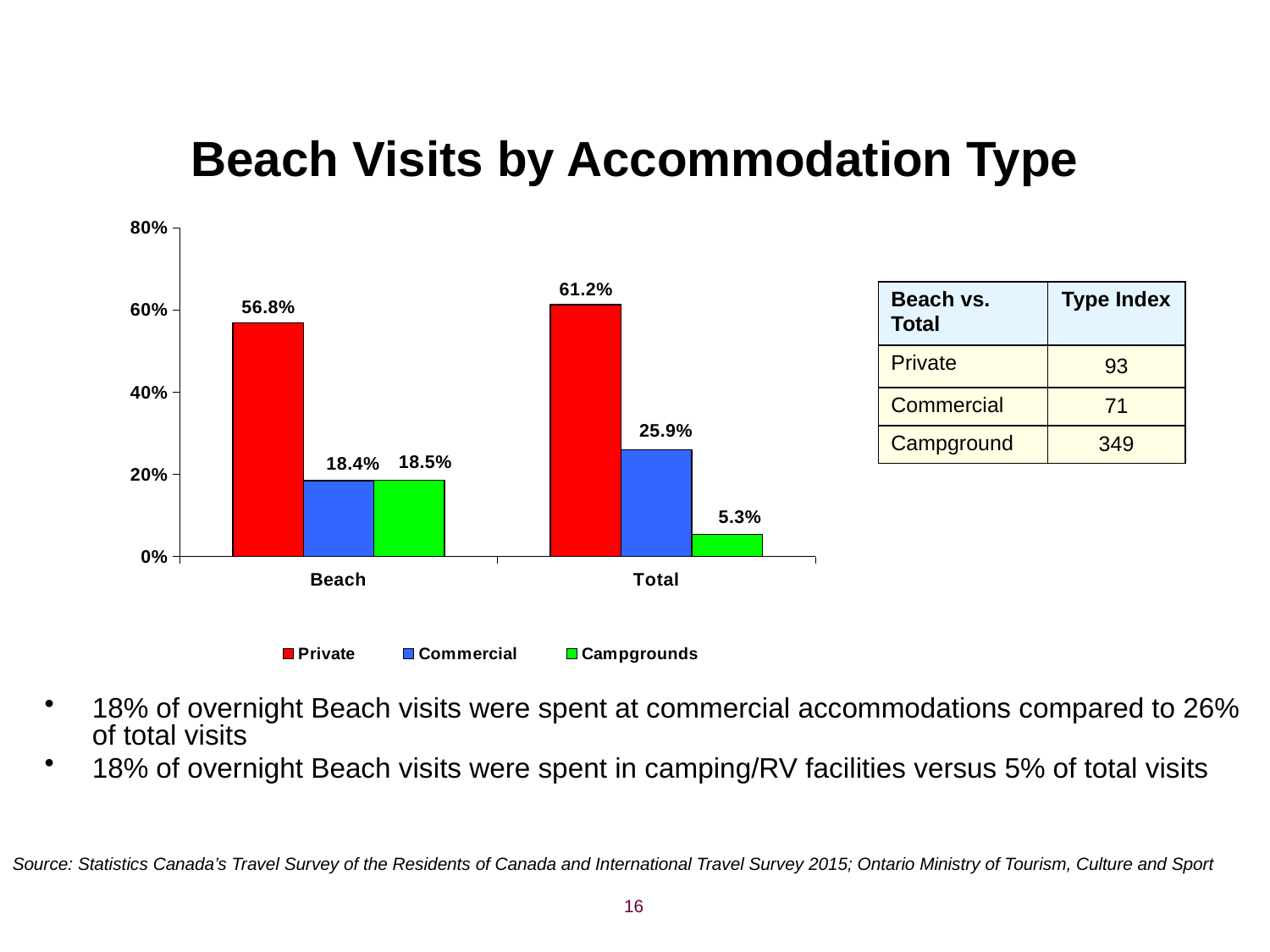
What is the value for Campgrounds in the Beach category? 18.5% What is the difference between the Private values for Total and Beach? 4.4% How many categories are shown on the x axis? 2 What kind of chart is shown on the slide? Bar chart Which series has the lowest value in the Total category? Campgrounds What is the difference between the Campgrounds values for Beach and Total? 13.2% Which is larger, the Commercial value for Beach or the Commercial value for Total? Total What is the value for Commercial in the Total category? 25.9% How many series does the legend list? 3 What is the value for Campgrounds in the Total category? 5.3% What is the value for Private in the Beach category? 56.8% Which series has the highest value in the Total category? Private